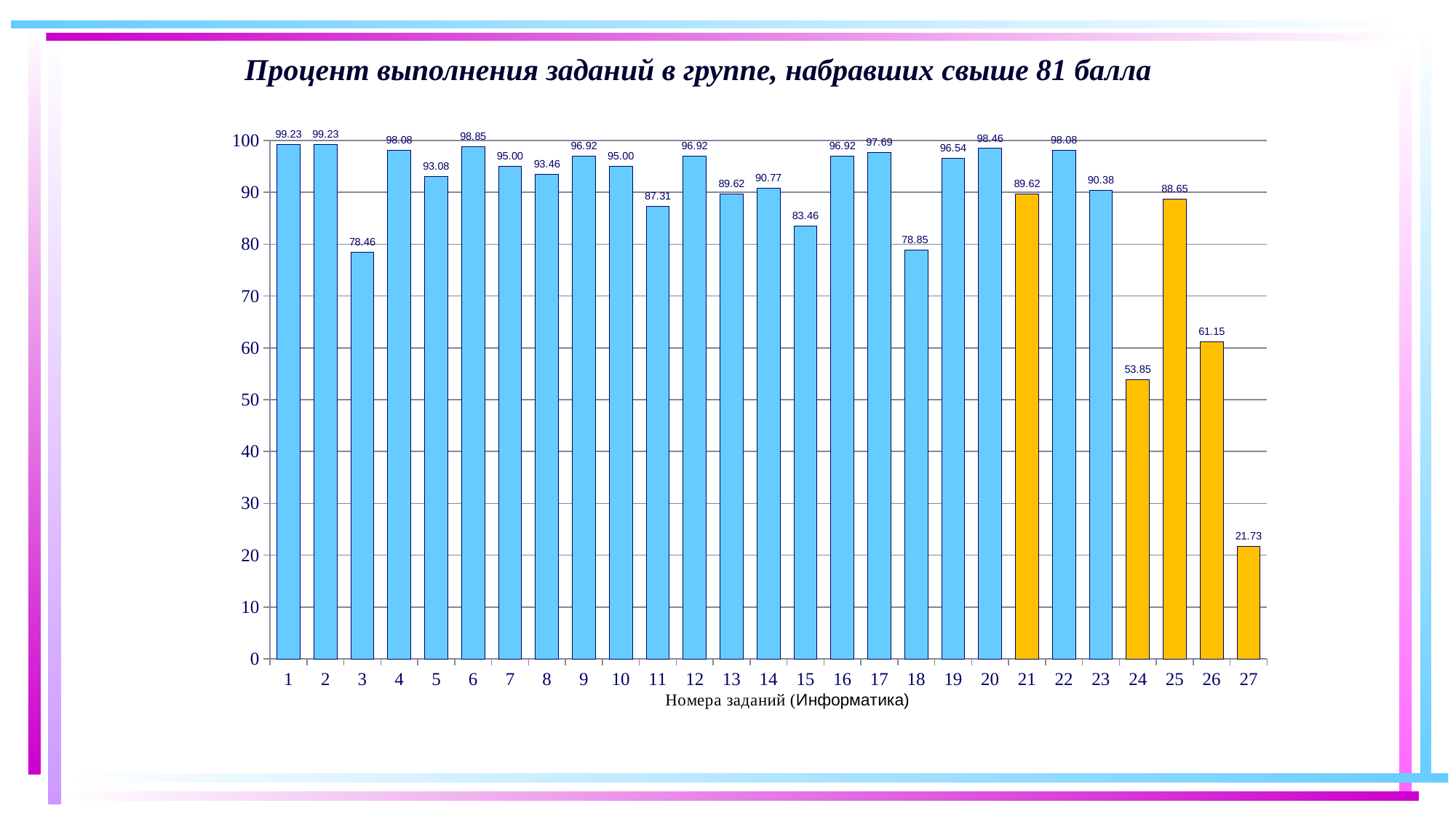
How many task numbers are shown on the x axis? 27 What is the difference between the values for task 26 and task 27? 39.42 What kind of chart is shown on the slide? bar chart What is the difference between the values for task 1 and task 3? 20.77 Which task numbers are shown with orange bars? 21, 24, 25, 26, 27 What is the value for task 3? 78.46 What is the value for task 17? 97.69 Which has a larger value, task 11 or task 15? task 11 What is the value for task 27? 21.73 Is the value for task 25 greater or less than 80? greater Which task number has the lowest value? 27 What is the value for task 24? 53.85